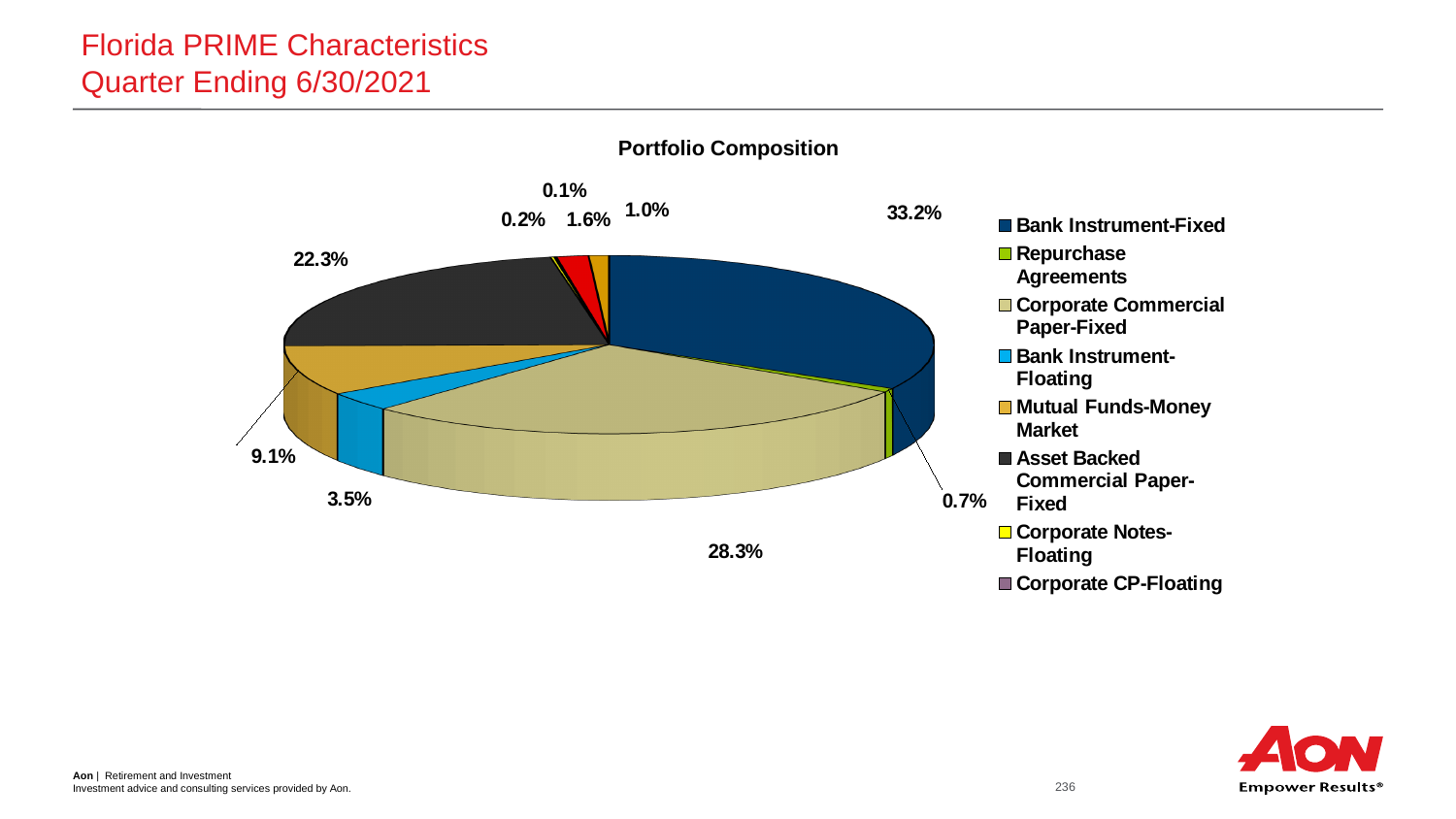
By how many percentage points does Bank Instrument-Fixed exceed Corporate Commercial Paper-Fixed? 4.9 percentage points What is the share of Bank Instrument-Floating? 3.5% What percentage of the portfolio is Bank Instrument-Fixed? 33.2% What is the smallest percentage label shown on the pie chart? 0.1% Which category makes up the largest share of the Portfolio Composition pie? Bank Instrument-Fixed What is the value shown for Asset Backed Commercial Paper-Fixed? 22.3% How many entries does the legend of the Portfolio Composition chart list? 8 What share does Corporate Commercial Paper-Fixed hold in the Portfolio Composition pie? 28.3% Which is larger, Mutual Funds-Money Market or Bank Instrument-Floating? Mutual Funds-Money Market What type of chart is used to show the Portfolio Composition? Pie chart What percentage is labelled for Mutual Funds-Money Market? 9.1% What percentage of the portfolio is in Repurchase Agreements? 0.7%